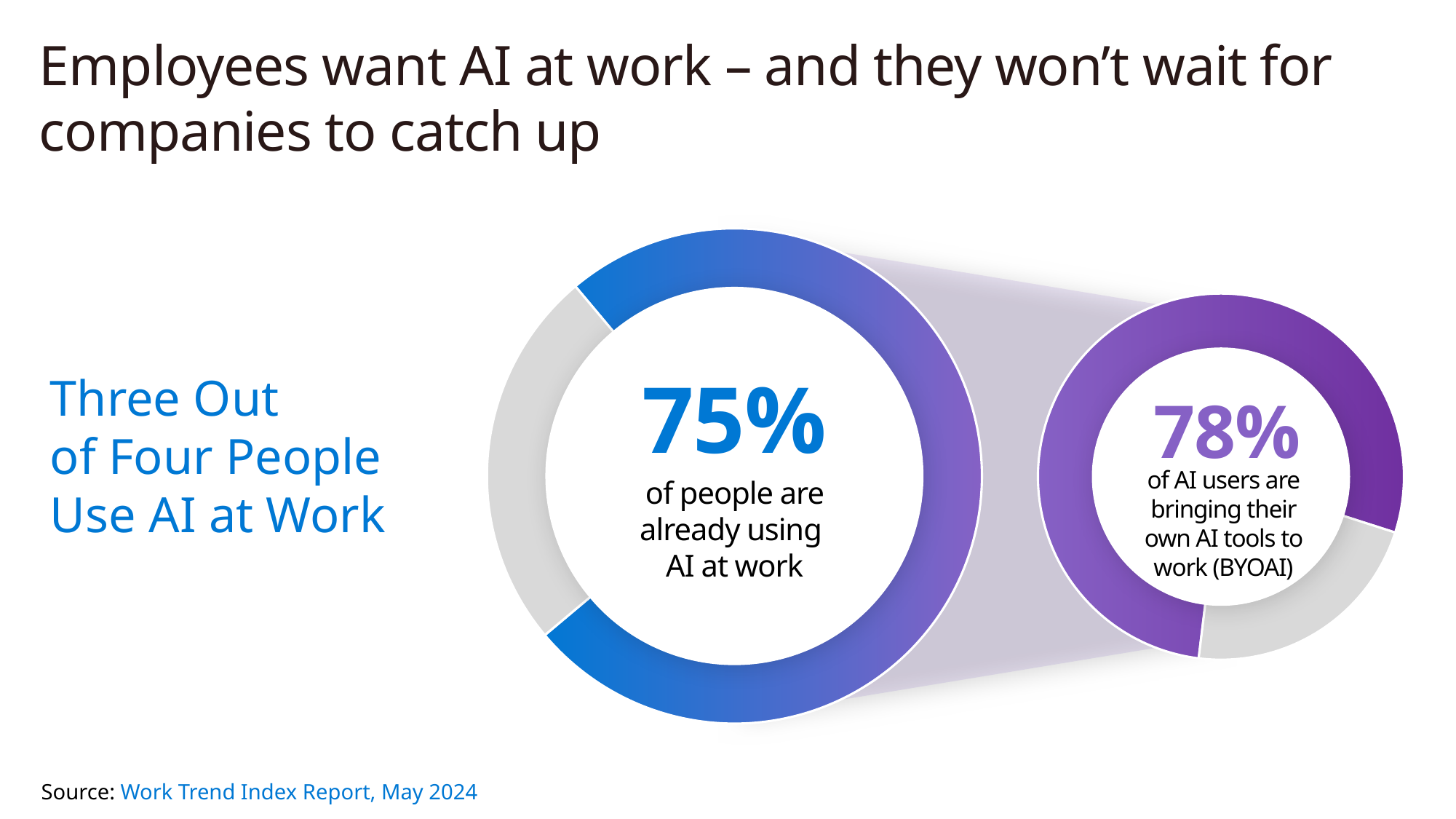
What is the difference between the 78% shown on the right chart and the 75% shown on the left chart? 3 percentage points What kind of chart is used to show the 78% figure on the right? Donut chart On the right donut chart, what share of the ring is grey (not filled in purple)? 22% How many donut charts are shown on the slide? 2 On the larger donut chart on the left, what percentage of people are already using AI at work? 75% On the left donut chart, what share of the ring is not filled in blue (the grey remainder)? 25% On the smaller donut chart on the right, what percentage of AI users are bringing their own AI tools to work (BYOAI)? 78% What source is cited for the data on the slide? Work Trend Index Report, May 2024 What kind of chart is used to show the 75% figure on the left? Donut chart Is the value shown on the left donut chart greater or less than 50%? greater Which is larger: the share of people already using AI at work (left chart) or the share of AI users bringing their own AI tools to work (right chart)? AI users bringing their own AI tools to work (78%) What colour is the filled portion of the left donut chart showing 75%? Blue